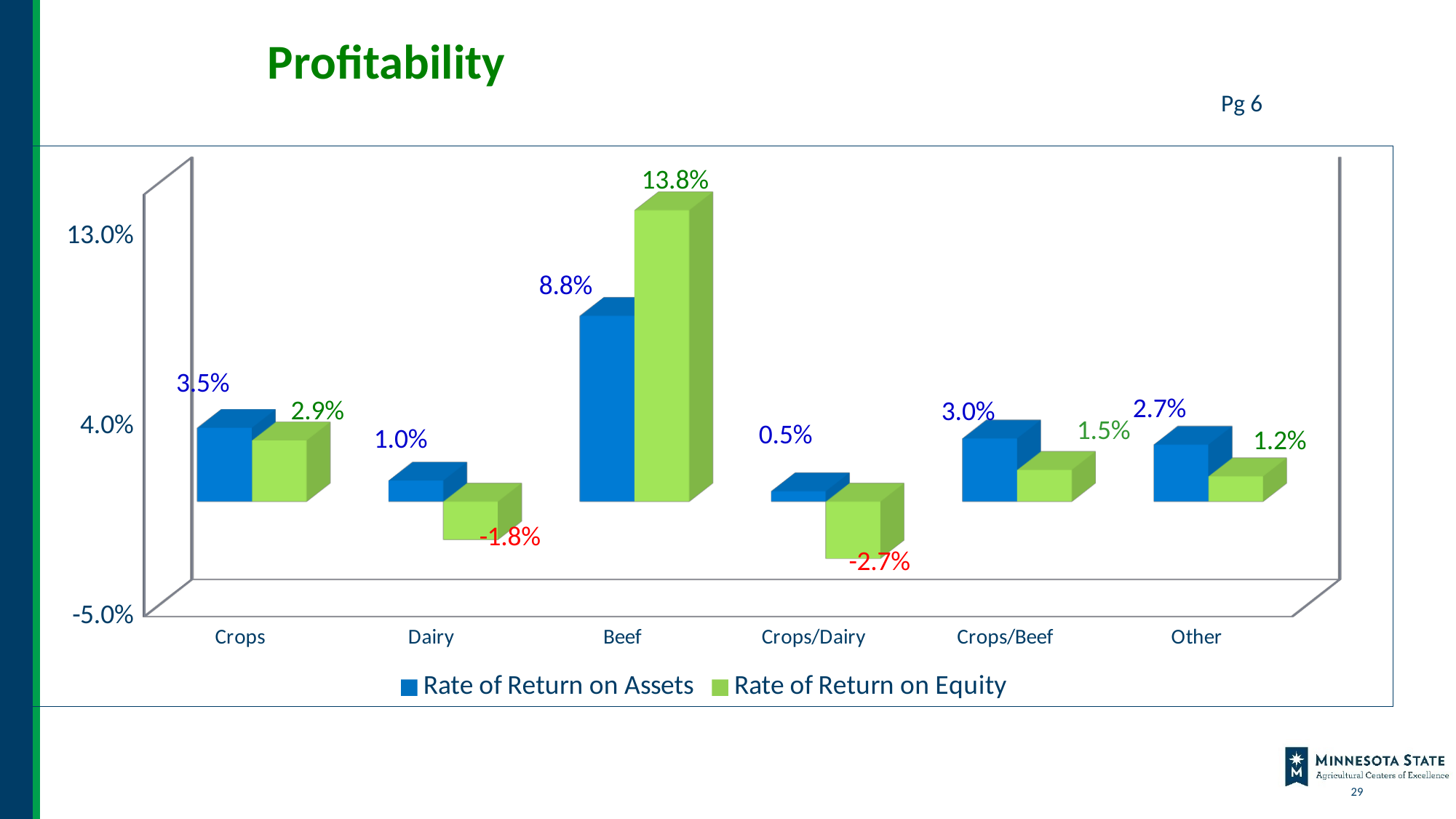
What kind of chart is shown on the slide? Bar chart Which category has the lowest Rate of Return on Assets? Crops/Dairy Which category has the highest Rate of Return on Equity? Beef How many categories are shown on the x axis? 6 What is the Rate of Return on Equity for Dairy? -1.8% Which is larger for Crops: the Rate of Return on Assets or the Rate of Return on Equity? Rate of Return on Assets What is the Rate of Return on Assets for Beef? 8.8% How many series does the legend list? 2 What is the title of the slide? Profitability What is the Rate of Return on Equity for Crops/Dairy? -2.7% What is the difference between the Rate of Return on Equity and the Rate of Return on Assets for Beef? 5.0% What is the Rate of Return on Assets for Other? 2.7%